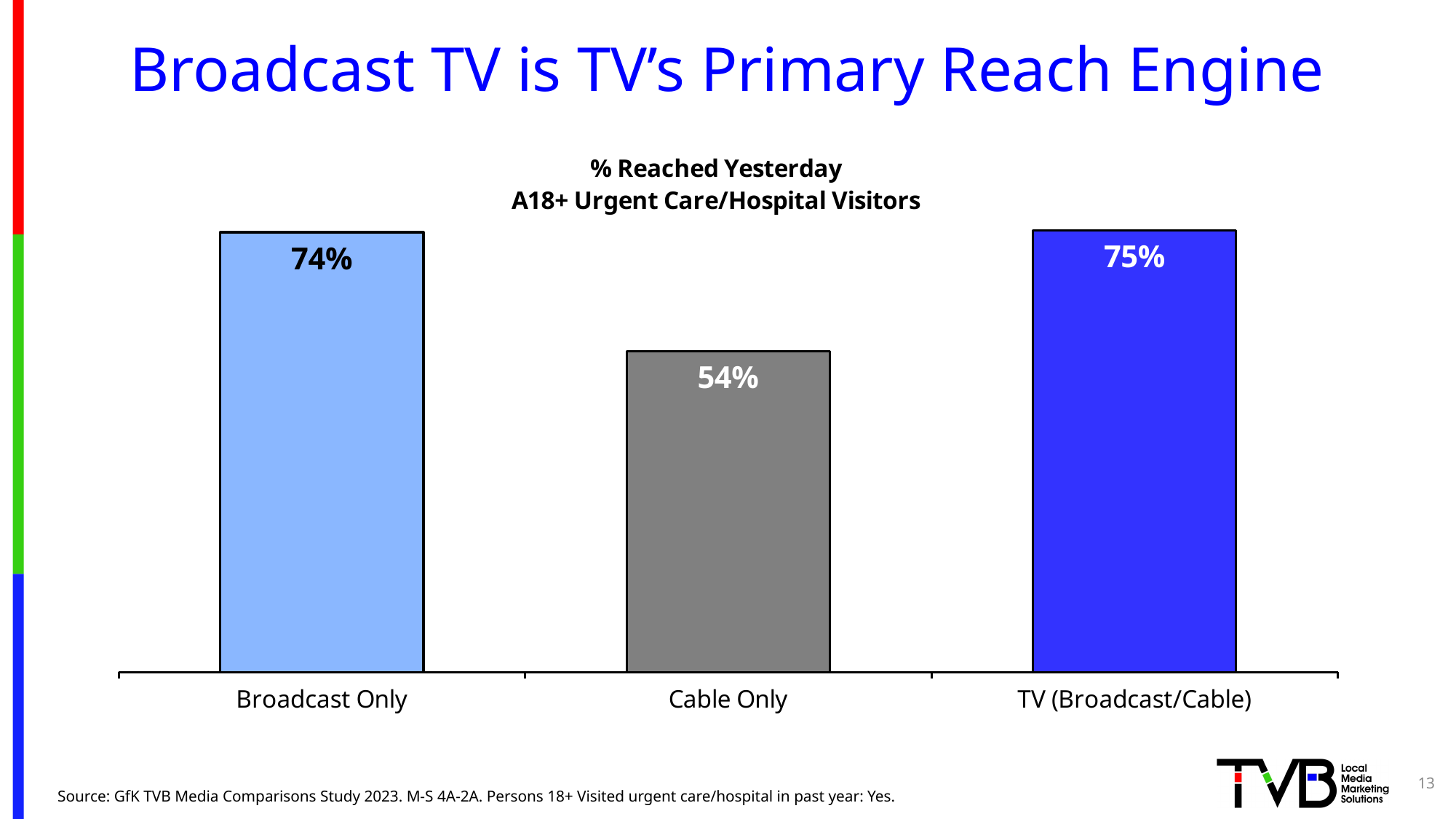
What is the value for Broadcast Only? 74% What colour is the Cable Only bar? Gray What is the difference between the values for Broadcast Only and Cable Only? 20% What is the value for Cable Only? 54% Which category has the highest value? TV (Broadcast/Cable) What is the value for TV (Broadcast/Cable)? 75% Which is larger, the value for Broadcast Only or the value for Cable Only? Broadcast Only What is the difference between the values for TV (Broadcast/Cable) and Broadcast Only? 1% What is the title of the chart? % Reached Yesterday A18+ Urgent Care/Hospital Visitors How many categories are shown in the chart? 3 Which category has the lowest value? Cable Only What kind of chart is shown on the slide? Bar chart